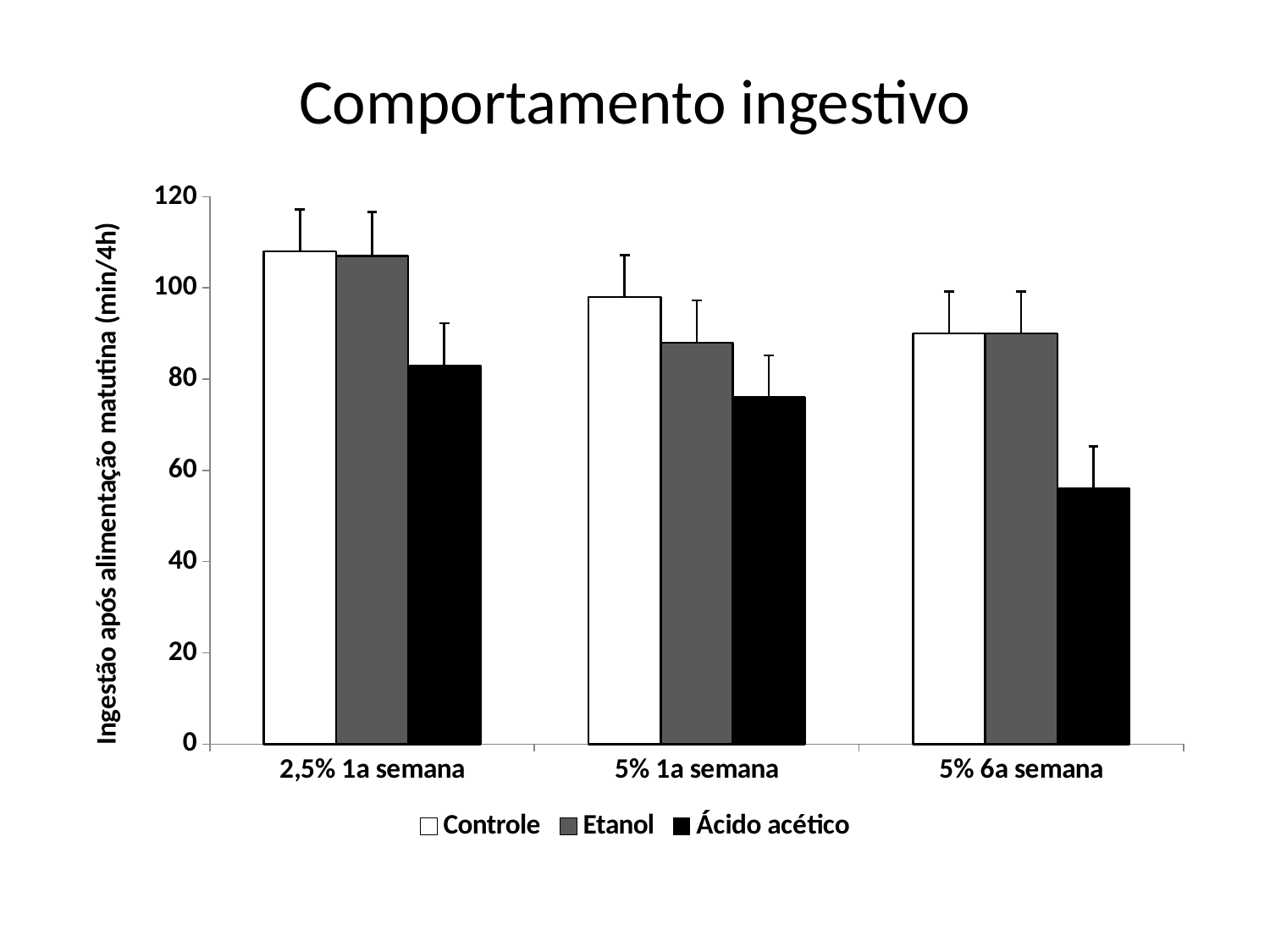
What is the label of the y axis? Ingestão após alimentação matutina (min/4h) Do the Ácido acético values rise or fall from 2,5% 1a semana to 5% 6a semana? fall For 5% 1a semana, which is larger: Controle or Etanol? Controle Is the Controle value for 2,5% 1a semana greater or less than 100? greater Is the Controle value for 5% 6a semana greater or less than 100? less What kind of chart is shown on the slide? bar chart Is the Etanol value for 5% 1a semana greater or less than 100? less What is the title of the chart? Comportamento ingestivo How many categories are shown on the x axis? 3 How many series does the legend list? 3 In which category is the Ácido acético bar lowest? 5% 6a semana